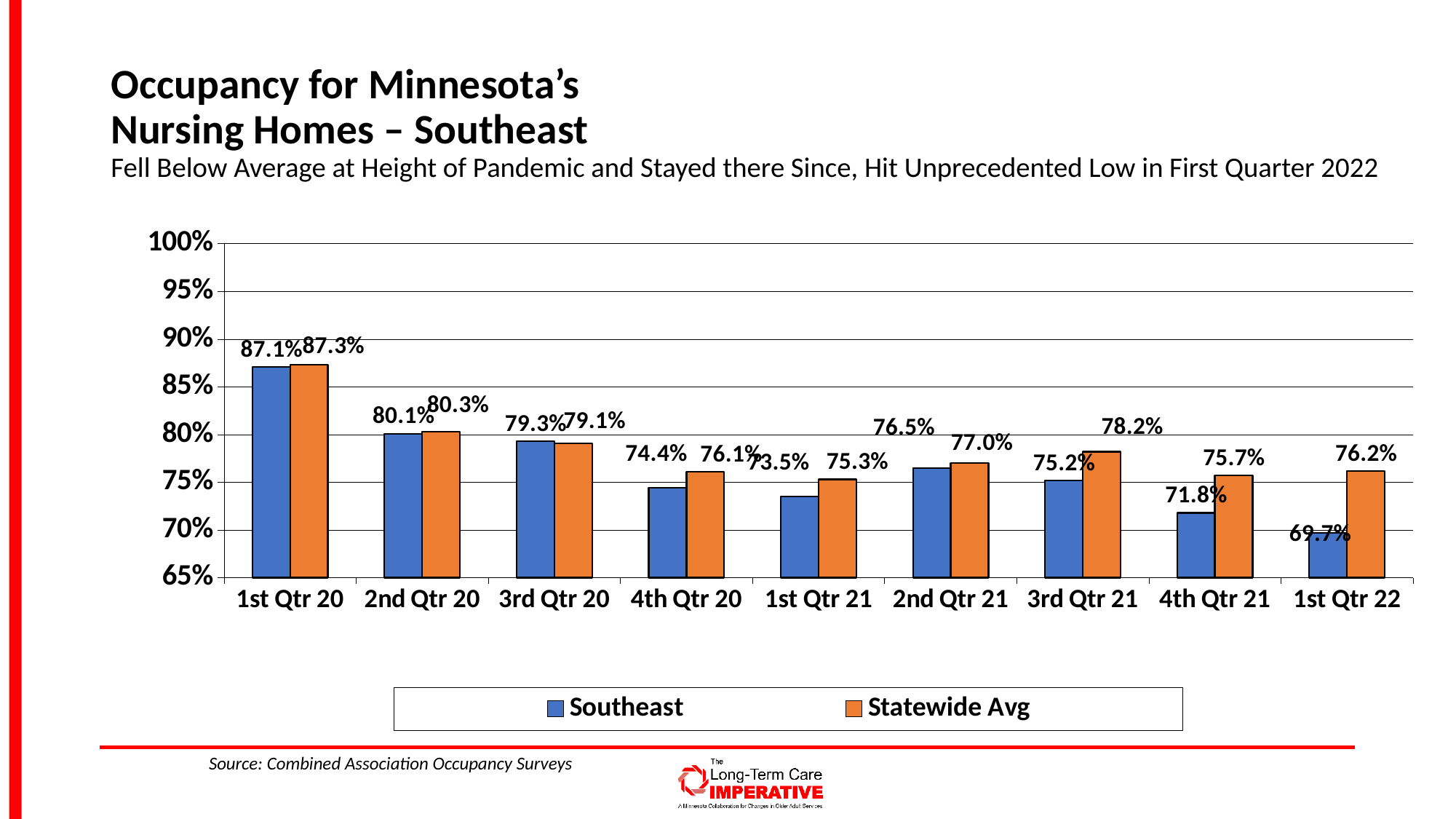
Is the Southeast value for 4th Qtr 21 greater or less than 75%? less How many series does the legend list? 2 What kind of chart is shown on the slide? Bar chart Does the Southeast occupancy rise or fall from 1st Qtr 20 to 1st Qtr 22? Fall In which quarter is the Southeast occupancy lowest? 1st Qtr 22 What is the Statewide Avg occupancy value for 3rd Qtr 21? 78.2% In which quarter is the Statewide Avg occupancy highest? 1st Qtr 20 How many quarters are shown on the x axis? 9 What is the Southeast occupancy value for 1st Qtr 22? 69.7% What is the difference between the Statewide Avg and Southeast values in 4th Qtr 21? 3.9 percentage points What colour represents the Statewide Avg series in the legend? Orange In 3rd Qtr 20, which is larger: the Southeast value or the Statewide Avg value? Southeast